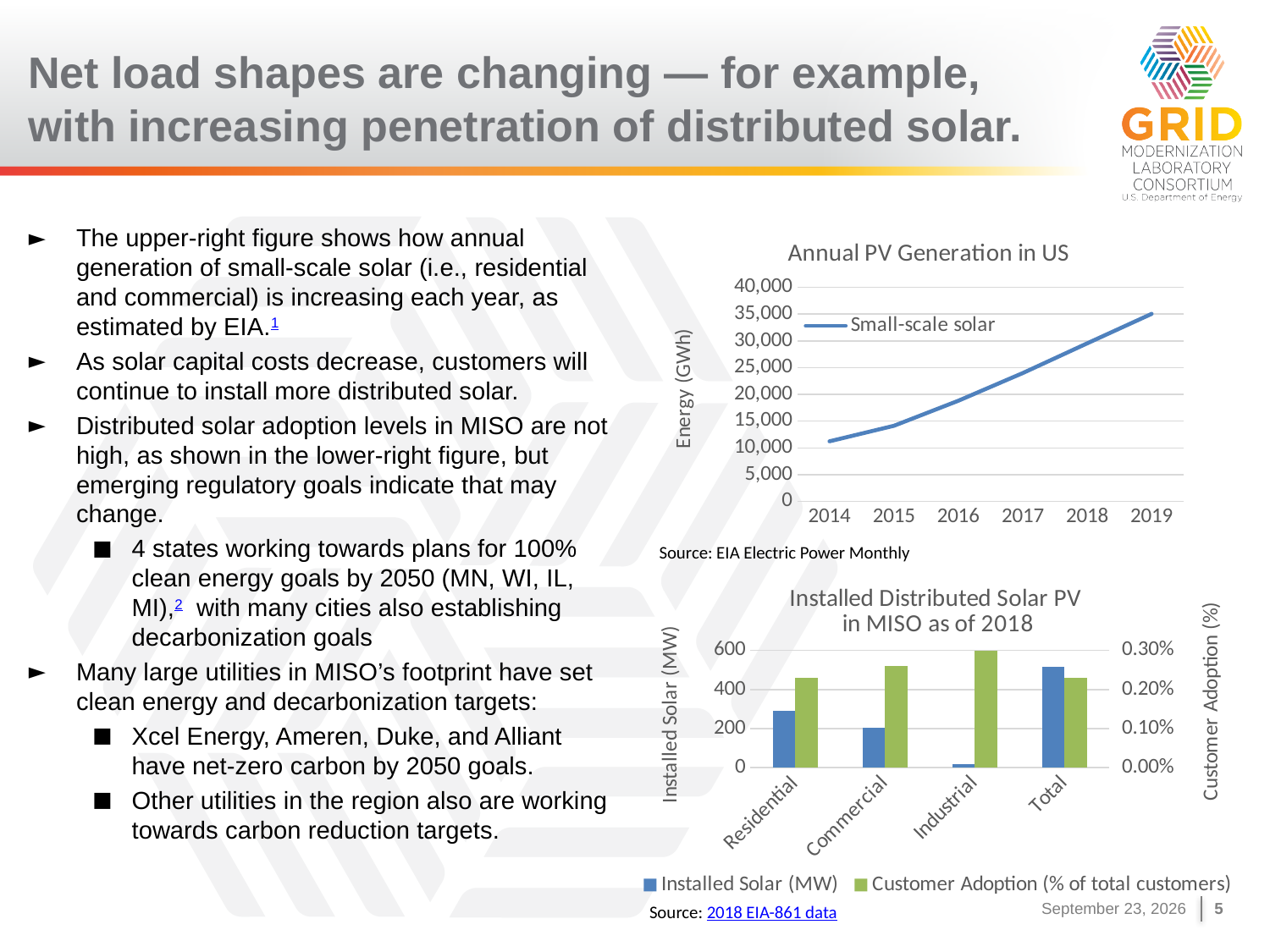
In the 'Annual PV Generation in US' chart, is the small-scale solar value for 2019 greater or less than 30,000? greater In the 'Annual PV Generation in US' chart, does small-scale solar generation rise or fall from 2014 to 2019? rise How many years are plotted on the x axis of the 'Annual PV Generation in US' chart? 6 In the 'Installed Distributed Solar PV in MISO as of 2018' chart, is the installed solar (MW) for Total greater or less than 400? greater In the 'Annual PV Generation in US' chart, is the small-scale solar value for 2014 greater or less than 15,000? less What type of chart is the 'Annual PV Generation in US' chart? line chart How many series does the legend of the 'Installed Distributed Solar PV in MISO as of 2018' chart list? 2 In the 'Installed Distributed Solar PV in MISO as of 2018' chart, which sector has the highest customer adoption (%)? Industrial What type of chart is the 'Installed Distributed Solar PV in MISO as of 2018' chart? bar chart In the 'Installed Distributed Solar PV in MISO as of 2018' chart, which sector (excluding Total) has the lowest installed solar (MW)? Industrial In the 'Annual PV Generation in US' chart, which year has the highest small-scale solar generation? 2019 In the 'Installed Distributed Solar PV in MISO as of 2018' chart, which has more installed solar (MW), Residential or Commercial? Residential